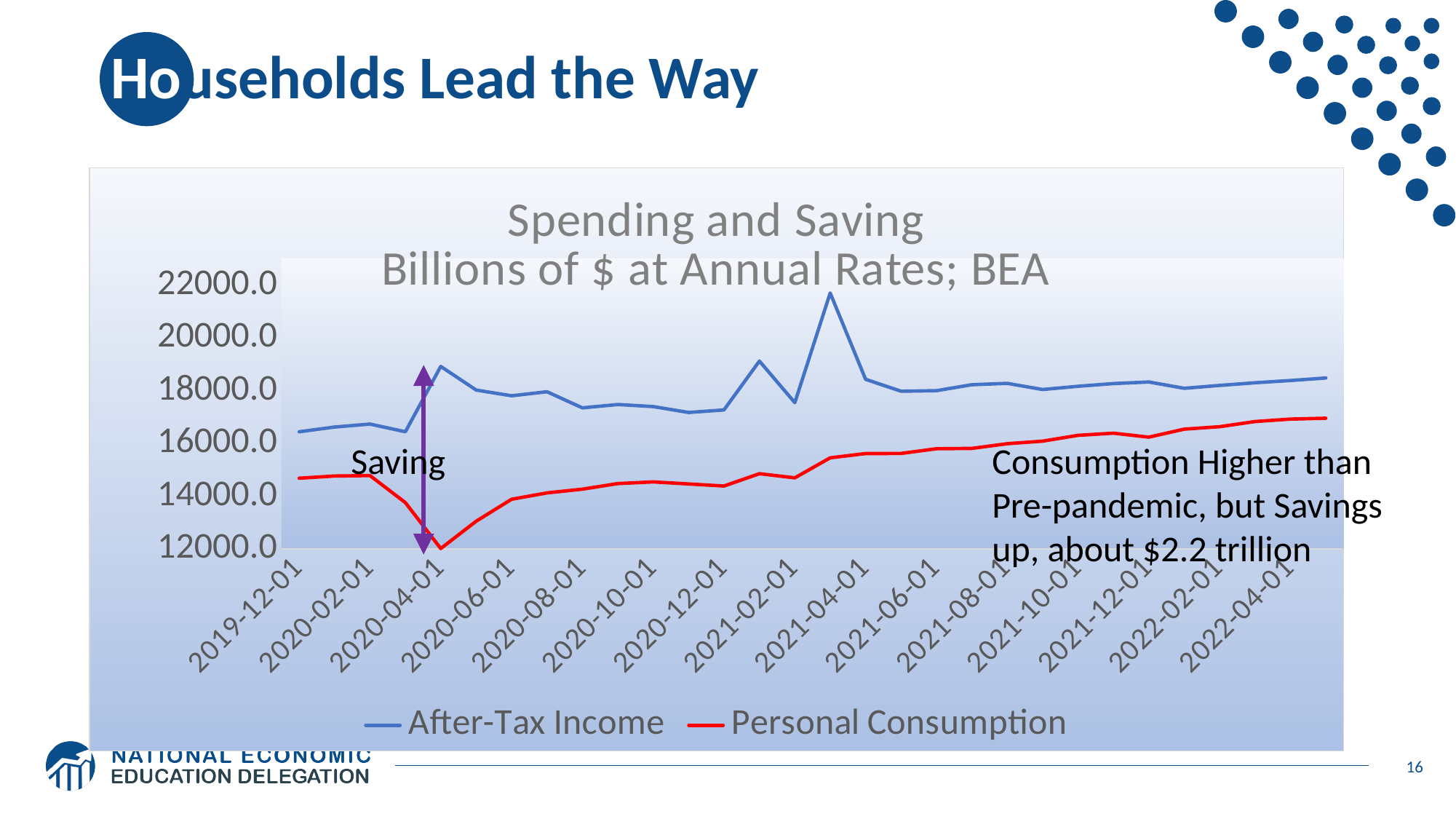
Is the value for Personal Consumption at 2022-04-01 greater or less than 16000.0? greater What are the two series named in the legend? After-Tax Income and Personal Consumption Which series has the higher value at 2019-12-01, After-Tax Income or Personal Consumption? After-Tax Income How many date labels are shown on the x axis? 15 What kind of chart is shown on the slide? Line chart Is the value for Personal Consumption at 2019-12-01 greater or less than 16000.0? less At which date does Personal Consumption reach its lowest value? 2020-04-01 Is the value for Personal Consumption at 2020-04-01 greater or less than 14000.0? less How many series does the legend list? 2 What colour is the Personal Consumption line? Red Does Personal Consumption generally rise or fall from 2020-06-01 to 2022-04-01? Rise